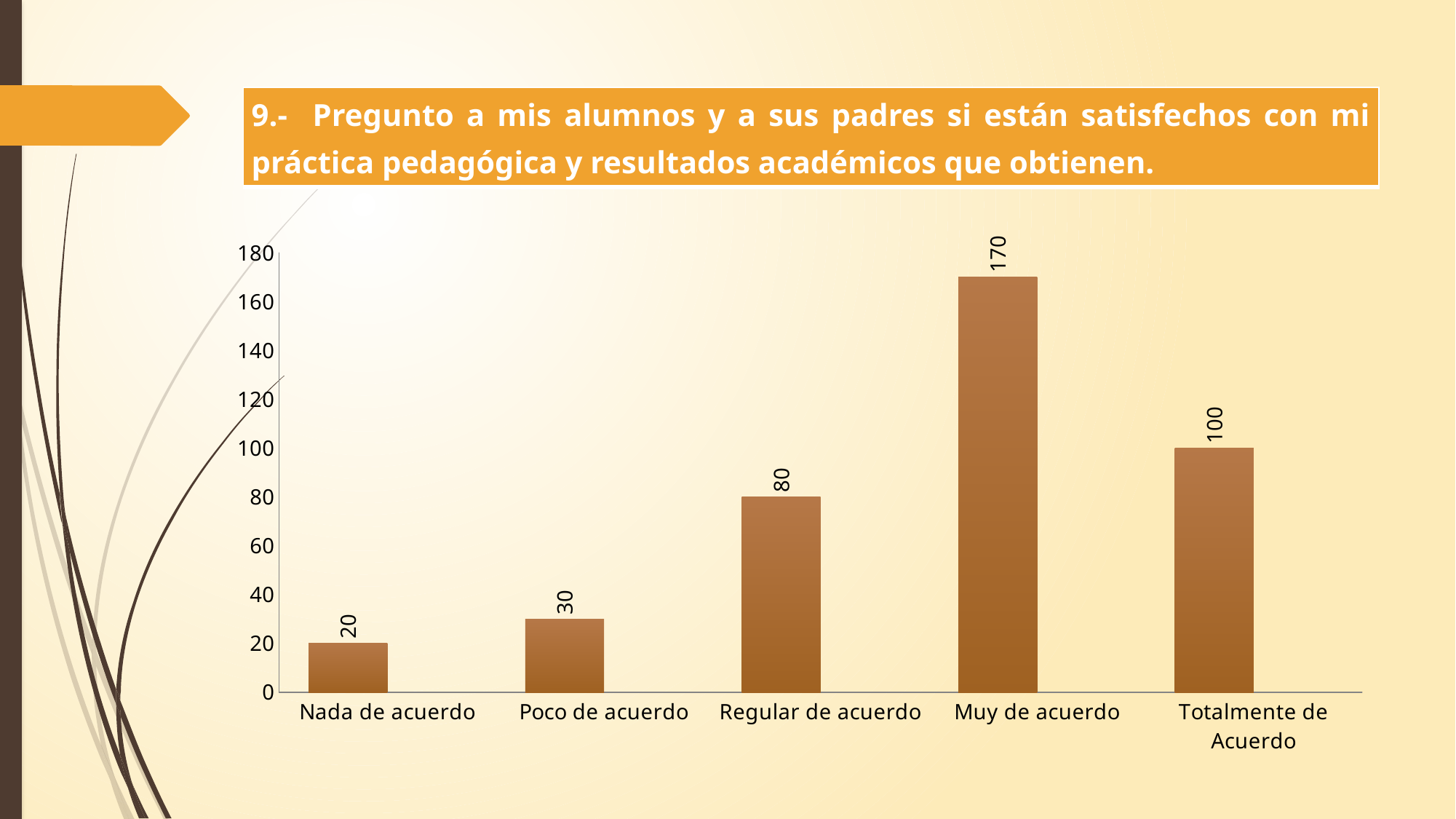
What is the highest value shown on the vertical axis? 180 How many categories are shown on the x axis? 5 What is the value for Nada de acuerdo? 20 Which category has the lowest value? Nada de acuerdo What is the value for Totalmente de Acuerdo? 100 What kind of chart is shown on the slide? Bar chart What is the difference between the values for Muy de acuerdo and Totalmente de Acuerdo? 70 Which is larger, the value for Poco de acuerdo or the value for Regular de acuerdo? Regular de acuerdo What is the value for Regular de acuerdo? 80 Which category has the highest value? Muy de acuerdo What is the difference between the values for Regular de acuerdo and Poco de acuerdo? 50 What is the value for Muy de acuerdo? 170